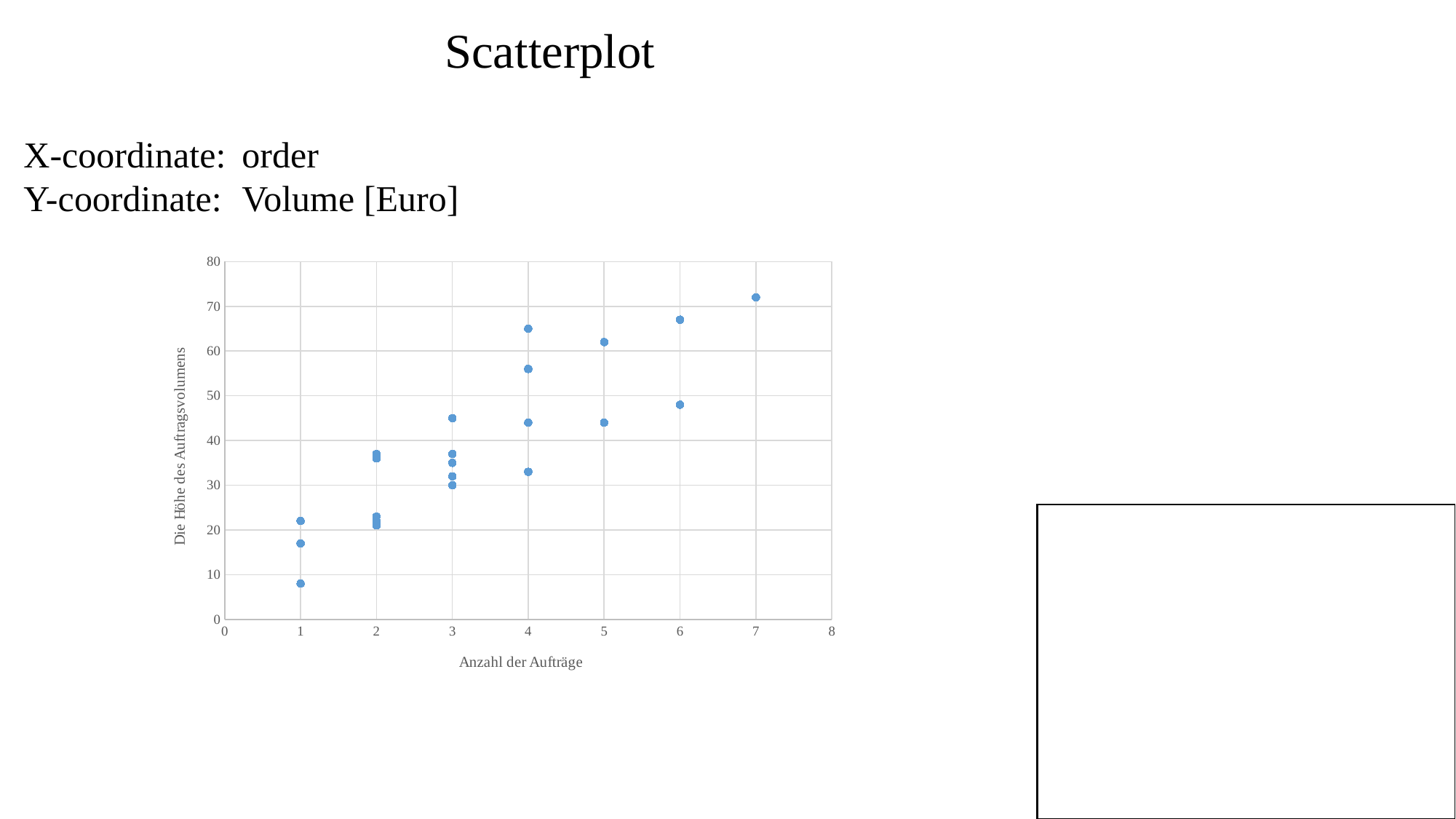
Is the value of the point at x = 7 greater or less than 60? greater Is the highest point at x = 4 greater or less than 60? greater Do the plotted volumes generally rise or fall as the number of orders increases along the x axis? rise At which x value (Anzahl der Aufträge) does the lowest point on the chart appear? 1 Is the lowest point at x = 1 greater or less than 10? less At which x value (Anzahl der Aufträge) does the highest point on the chart appear? 7 What is the maximum value shown on the y axis of the chart? 80 What is the title of the x axis of the chart? Anzahl der Aufträge How many distinct x values (Anzahl der Aufträge) have points plotted on the chart? 7 What kind of chart is shown on the slide? scatter plot